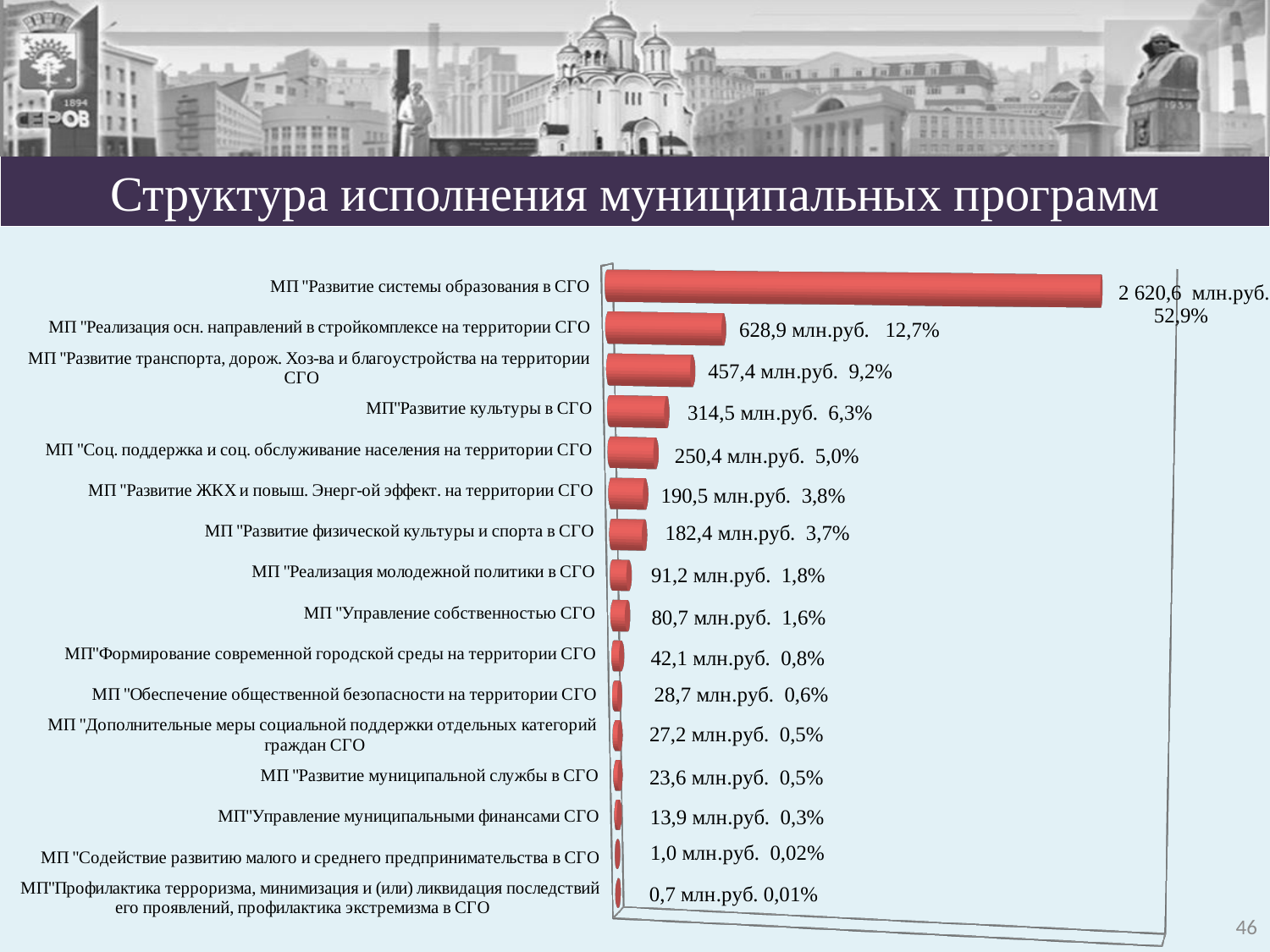
Which programme has the lowest value? МП"Профилактика терроризма, минимизация и (или) ликвидация последствий его проявлений, профилактика экстремизма в СГО" Which is larger: the value for МП "Развитие ЖКХ и повыш. Энерг-ой эффект. на территории СГО" or for МП "Развитие физической культуры и спорта в СГО"? МП "Развитие ЖКХ и повыш. Энерг-ой эффект. на территории СГО" What is the value for МП "Развитие системы образования в СГО"? 2 620,6 млн.руб. What is the value for МП "Развитие культуры в СГО"? 314,5 млн.руб. Which programme has the highest value? МП "Развитие системы образования в СГО" What percentage is shown for МП "Реализация молодежной политики в СГО"? 1,8% What type of chart is shown on the slide? bar chart What is the title of the slide? Структура исполнения муниципальных программ What is the difference in млн.руб. between МП "Реализация осн. направлений в стройкомплексе на территории СГО" and МП "Развитие транспорта, дорож. Хоз-ва и благоустройства на территории СГО"? 171,5 млн.руб. What is the value for МП "Содействие развитию малого и среднего предпринимательства в СГО"? 1,0 млн.руб. How many municipal programmes (categories) are plotted in the chart? 16 What share does МП "Развитие системы образования в СГО" account for? 52,9%